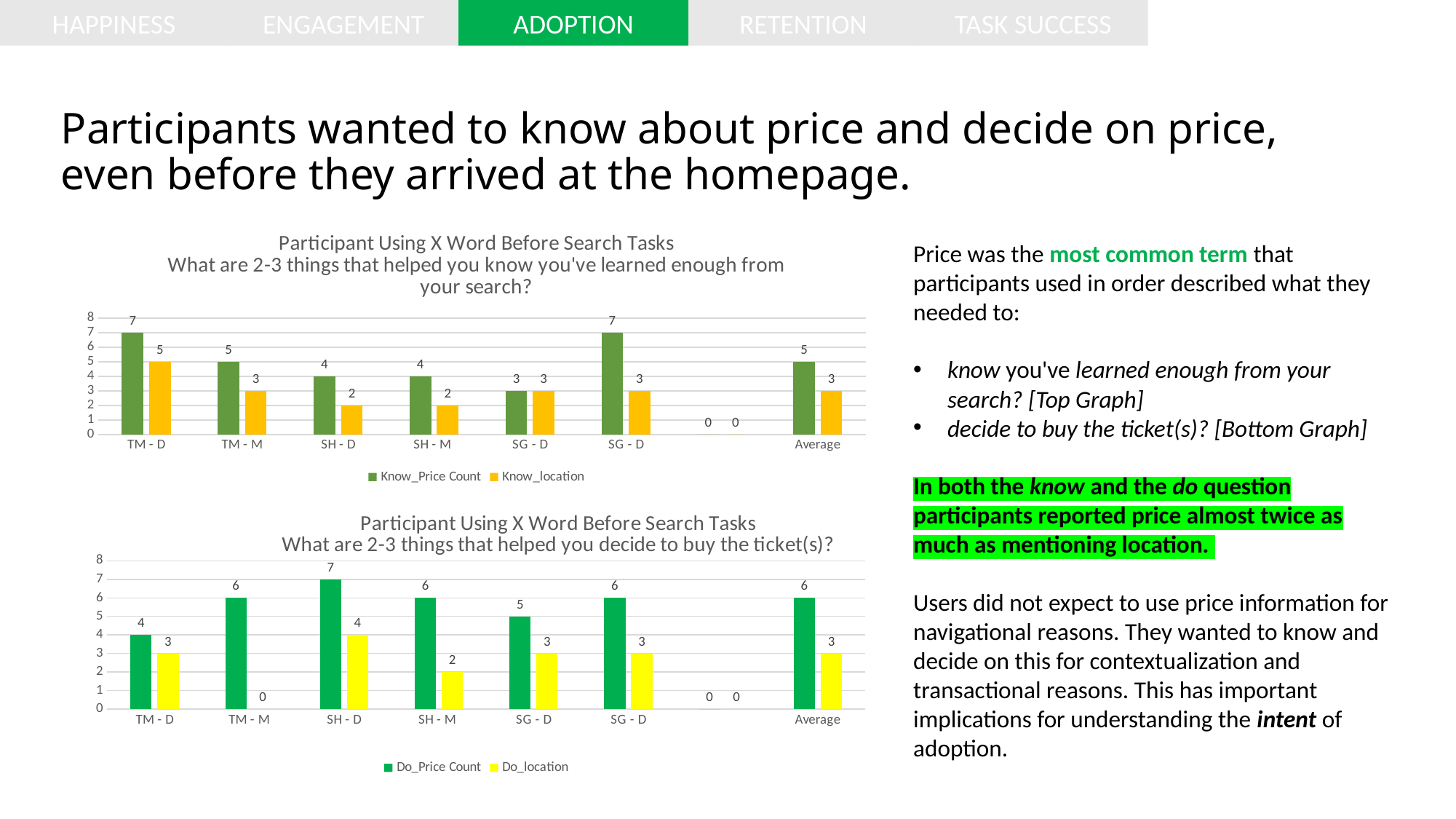
In the bottom chart (decide to buy the ticket(s)), what is the Do_Price Count value for SH - D? 7 In the bottom chart (decide to buy the ticket(s)), what colour are the Do_location bars? Yellow What type of chart is the bottom chart (decide to buy the ticket(s))? Bar chart In the bottom chart (decide to buy the ticket(s)), which is larger for SH - M: Do_Price Count or Do_location? Do_Price Count In the top chart (know you've learned enough from your search), what is the Average value for Know_Price Count? 5 In the bottom chart (decide to buy the ticket(s)), what is the Do_location value for TM - M? 0 In the top chart (know you've learned enough from your search), what is the Know_location value for TM - M? 3 In the bottom chart (decide to buy the ticket(s)), what is the difference between the Average Do_Price Count and the Average Do_location? 3 In the top chart (know you've learned enough from your search), how many series does the legend list? 2 In the bottom chart (decide to buy the ticket(s)), which category has the highest Do_Price Count? SH - D In the top chart (know you've learned enough from your search), what is the difference between the Know_Price Count and Know_location values for TM - D? 2 In the top chart (know you've learned enough from your search), what is the Know_Price Count value for TM - D? 7